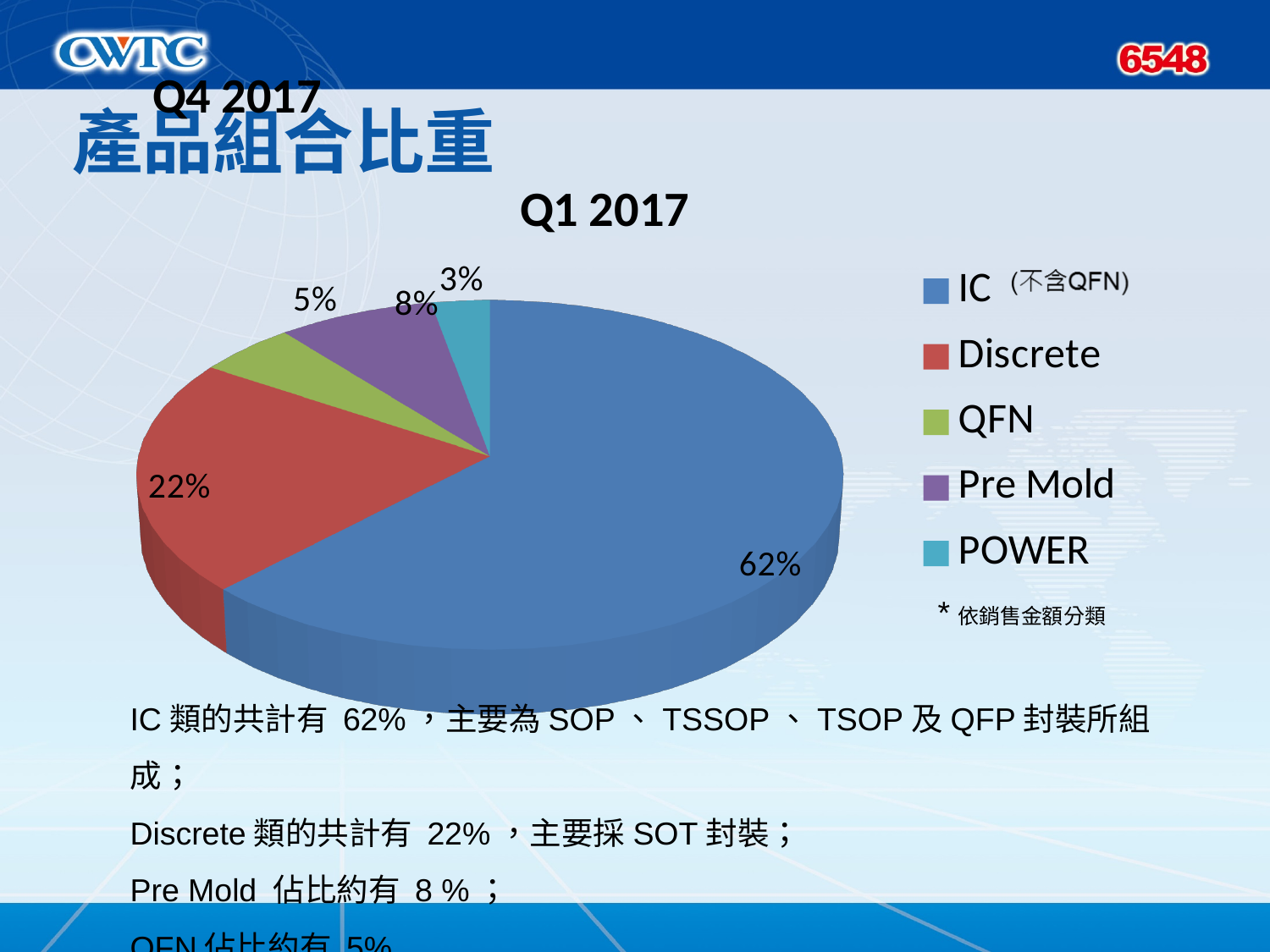
What share of the pie does POWER hold? 3% What is the difference in percentage points between the IC and Discrete slices? 40 What kind of chart is shown on the slide? Pie chart What share of the pie does Pre Mold hold? 8% Which category has the largest slice of the pie? IC What is the title of the chart? Q1 2017 Which is larger, the Pre Mold slice or the QFN slice? Pre Mold How many slices does the pie chart have? 5 What share of the pie does IC hold? 62% What share of the pie does Discrete hold? 22% Which category has the smallest slice of the pie? POWER What share of the pie does QFN hold? 5%